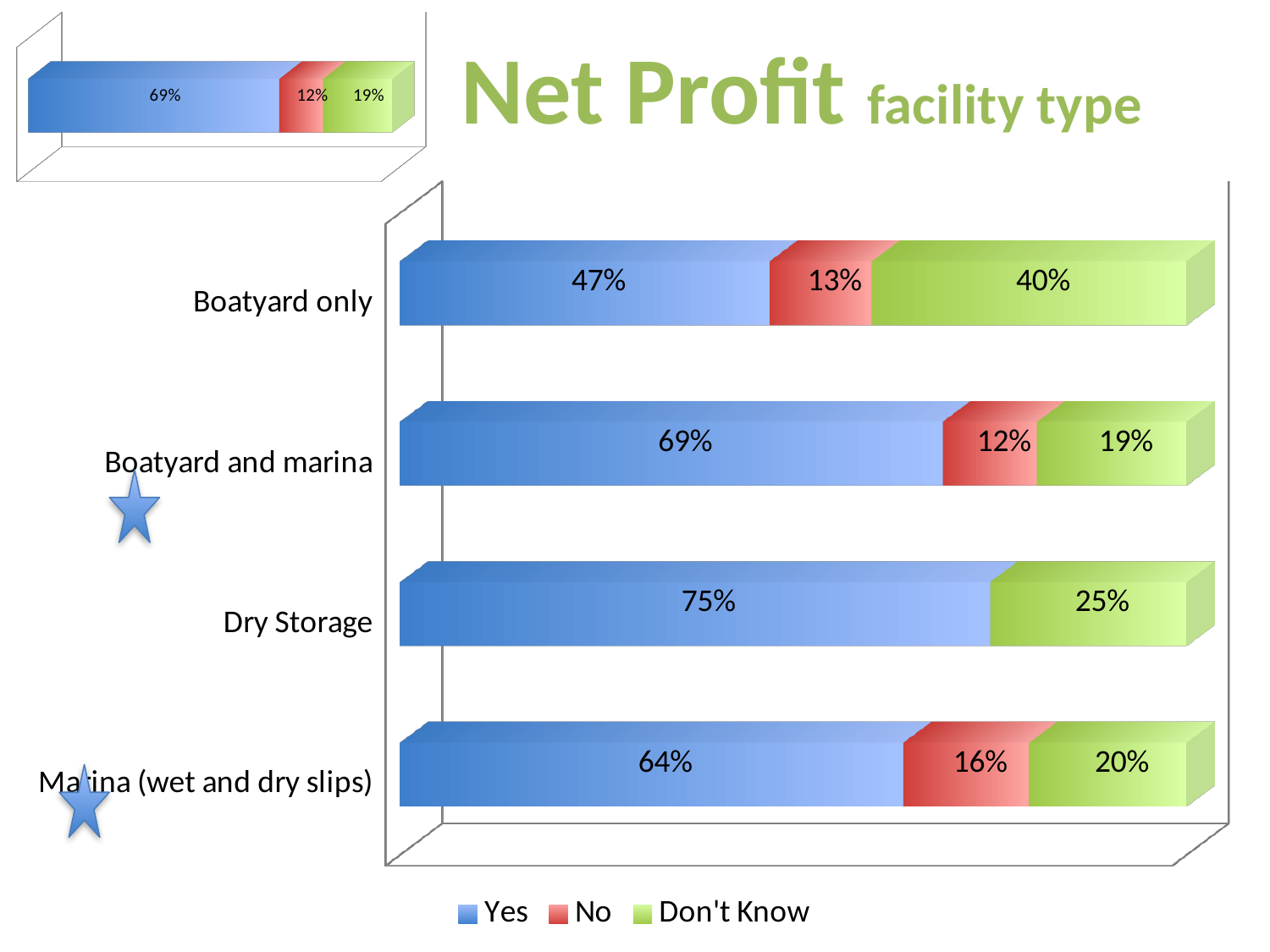
In the large chart, which facility type has the highest Yes percentage? Dry Storage In the small chart at the top left of the slide, what is the value of the blue segment? 69% In the large chart, what is the Don't Know value for Boatyard only? 40% In the large chart, what percentage of Boatyard only respondents answered Yes? 47% In the large chart, what is the No value for Marina (wet and dry slips)? 16% In the large chart, which is larger: the Don't Know value for Boatyard only or for Marina (wet and dry slips)? Boatyard only In the large chart, which facility type has the lowest Yes percentage? Boatyard only In the large chart, what is the difference between the Yes values for Boatyard and marina and Boatyard only? 22% What kind of chart is the large chart on the slide? Stacked bar chart How many series does the legend of the large chart list? 3 How many facility types are shown in the large chart? 4 In the large chart, what is the Don't Know value for Dry Storage? 25%